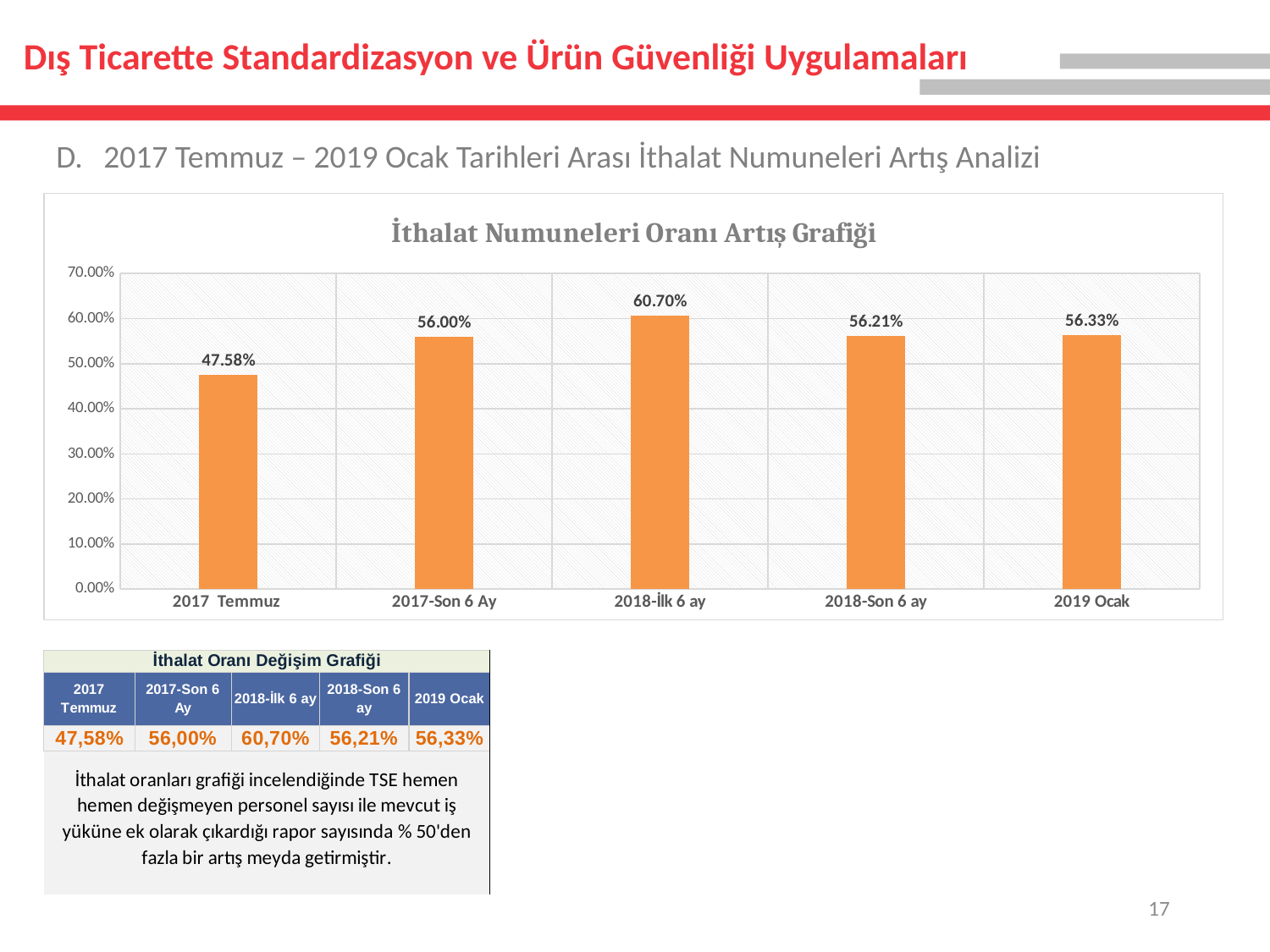
What is the value for 2017 Temmuz in the İthalat Numuneleri Oranı Artış Grafiği chart? 47.58% What is the value for 2019 Ocak in the chart? 56.33% How many periods are shown on the x axis of the chart? 5 What is the value for 2018-İlk 6 ay in the chart? 60.70% What is the difference between the values for 2018-İlk 6 ay and 2017-Son 6 Ay? 4.70 percentage points Which is larger, the value for 2017 Temmuz or the value for 2017-Son 6 Ay? 2017-Son 6 Ay Is the value for 2017 Temmuz greater or less than 50.00%? less Which period has the highest value in the chart? 2018-İlk 6 ay Which period has the lowest value in the chart? 2017 Temmuz Do the values rise or fall from 2017 Temmuz to 2018-İlk 6 ay? rise What kind of chart is shown on the slide? bar chart What is the difference between the values for 2018-İlk 6 ay and 2017 Temmuz? 13.12 percentage points